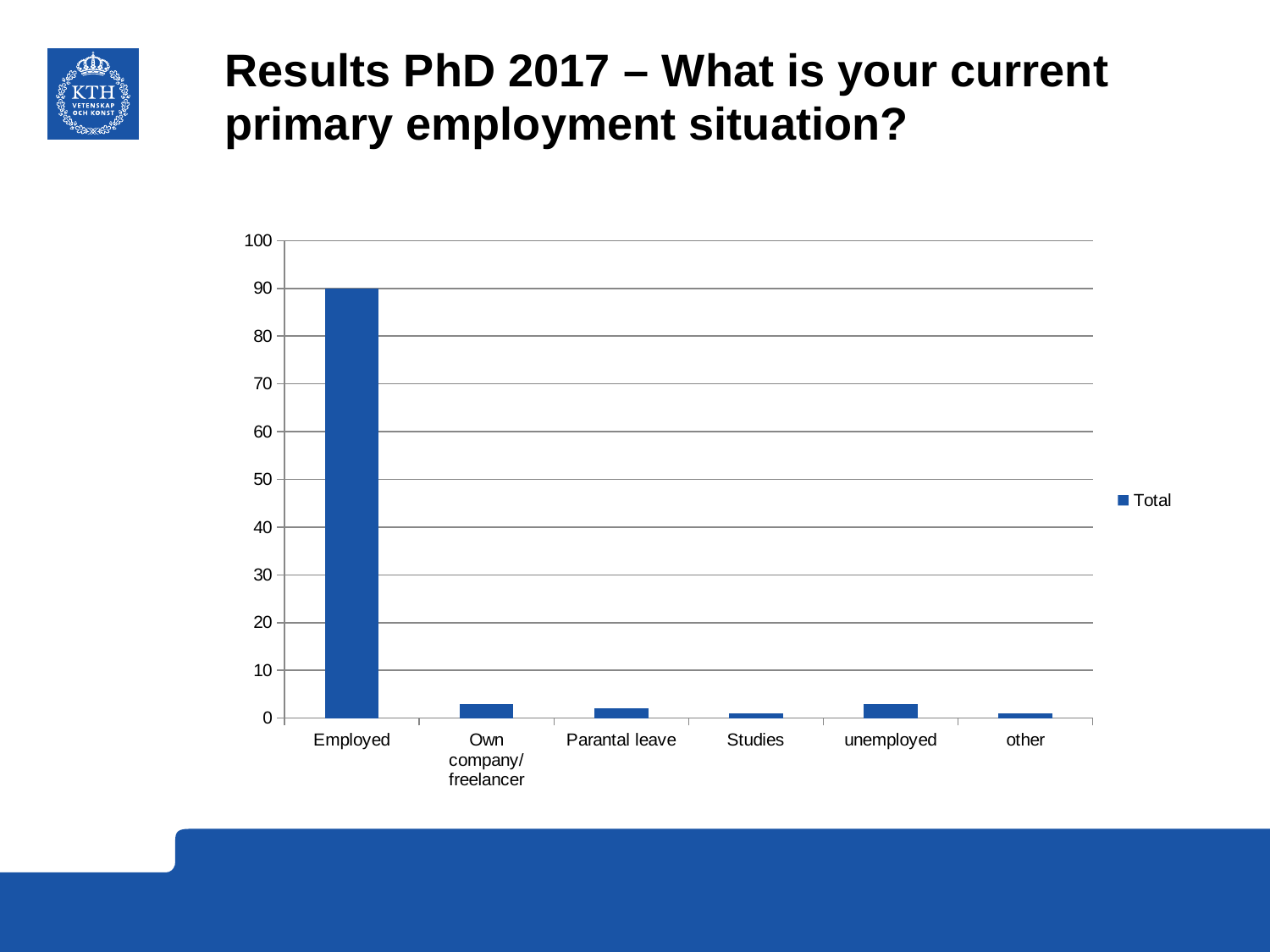
Which is larger, the value for Employed or the value for unemployed? Employed Is the value for Parantal leave greater or less than 20? less What kind of chart is shown on the slide? bar chart Which category has the highest value in the chart? Employed How many categories are shown on the x axis of the chart? 6 Is the value for unemployed greater or less than 10? less Is the value for Own company/freelancer greater or less than 10? less Which is larger, the value for Own company/freelancer or the value for Studies? Own company/freelancer How many series does the chart's legend list? 1 What is the value for Employed? 90 What is the name of the series listed in the legend? Total